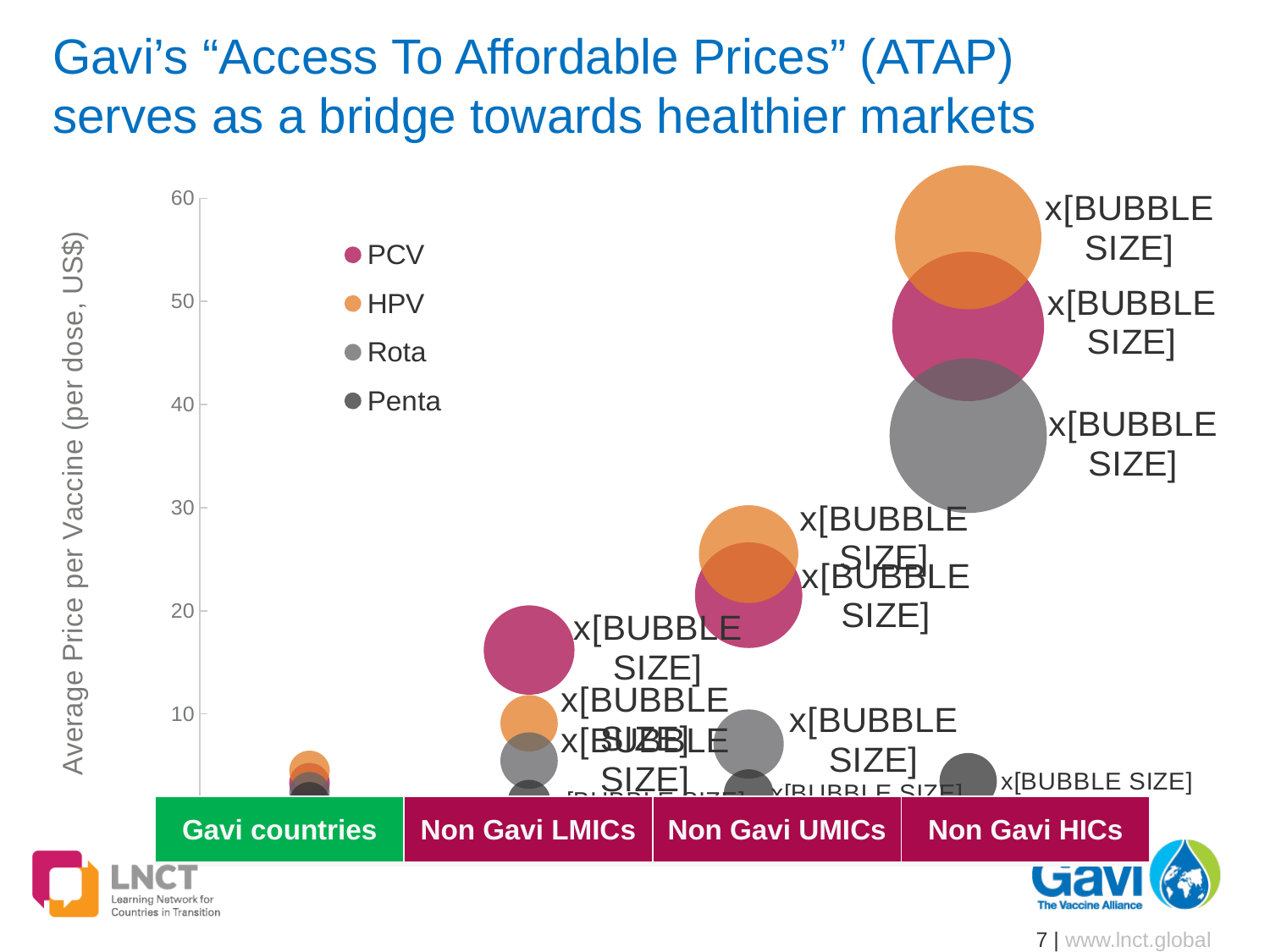
Which series is plotted in orange? HPV Do average vaccine prices rise or fall moving from Gavi countries to Non Gavi HICs along the x axis? rise How many series does the legend list? 4 Is the Rota value for Non Gavi UMICs greater or less than 10? less Which country group has the highest average price for HPV? Non Gavi HICs Is the Rota value for Non Gavi HICs greater or less than 30? greater Is the PCV value for Non Gavi LMICs greater or less than 10? greater What is the title of the vertical axis? Average Price per Vaccine (per dose, US$) How many country groups are shown along the x axis? 4 What kind of chart is shown on the slide? Bubble chart